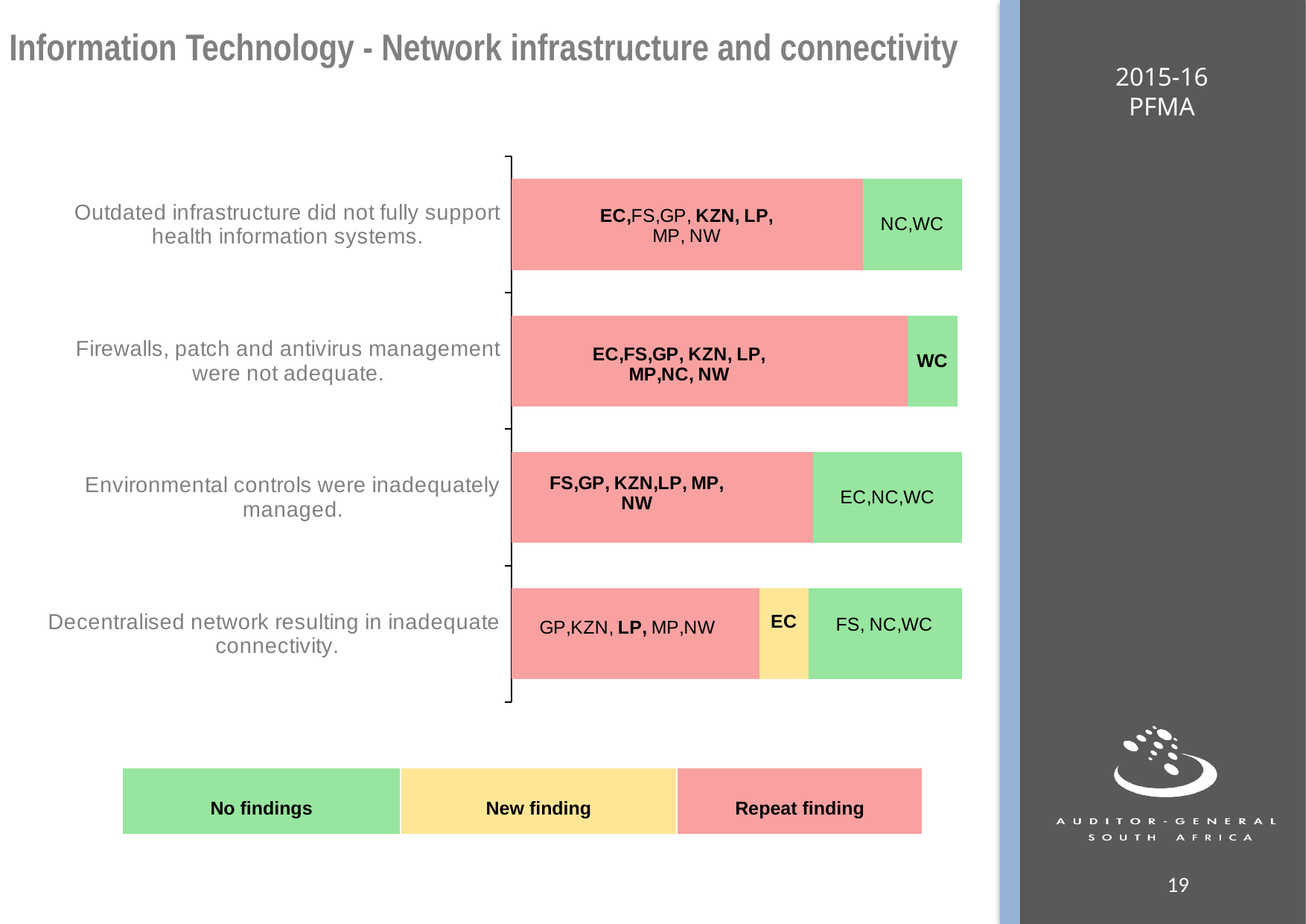
Which finding has the largest 'Repeat finding' segment? Firewalls, patch and antivirus management were not adequate. Which provinces are listed in the 'No findings' segment for 'Environmental controls were inadequately managed.'? EC,NC,WC Which provinces are listed in the 'No findings' segment for 'Outdated infrastructure did not fully support health information systems.'? NC,WC Which province is listed as a 'New finding' for 'Decentralised network resulting in inadequate connectivity.'? EC How many series does the legend list? 3 Which finding is the only one with a 'New finding' segment? Decentralised network resulting in inadequate connectivity. How many provinces are listed in the 'Repeat finding' segment for 'Firewalls, patch and antivirus management were not adequate.'? 8 What kind of chart is shown on the slide? Stacked bar chart How many categories (findings) are plotted on the chart? 4 Which province is listed in the 'No findings' segment for 'Firewalls, patch and antivirus management were not adequate.'? WC Which provinces are listed in the 'Repeat finding' segment for 'Decentralised network resulting in inadequate connectivity.'? GP,KZN, LP, MP,NW What colour does the legend use for 'Repeat finding'? Red